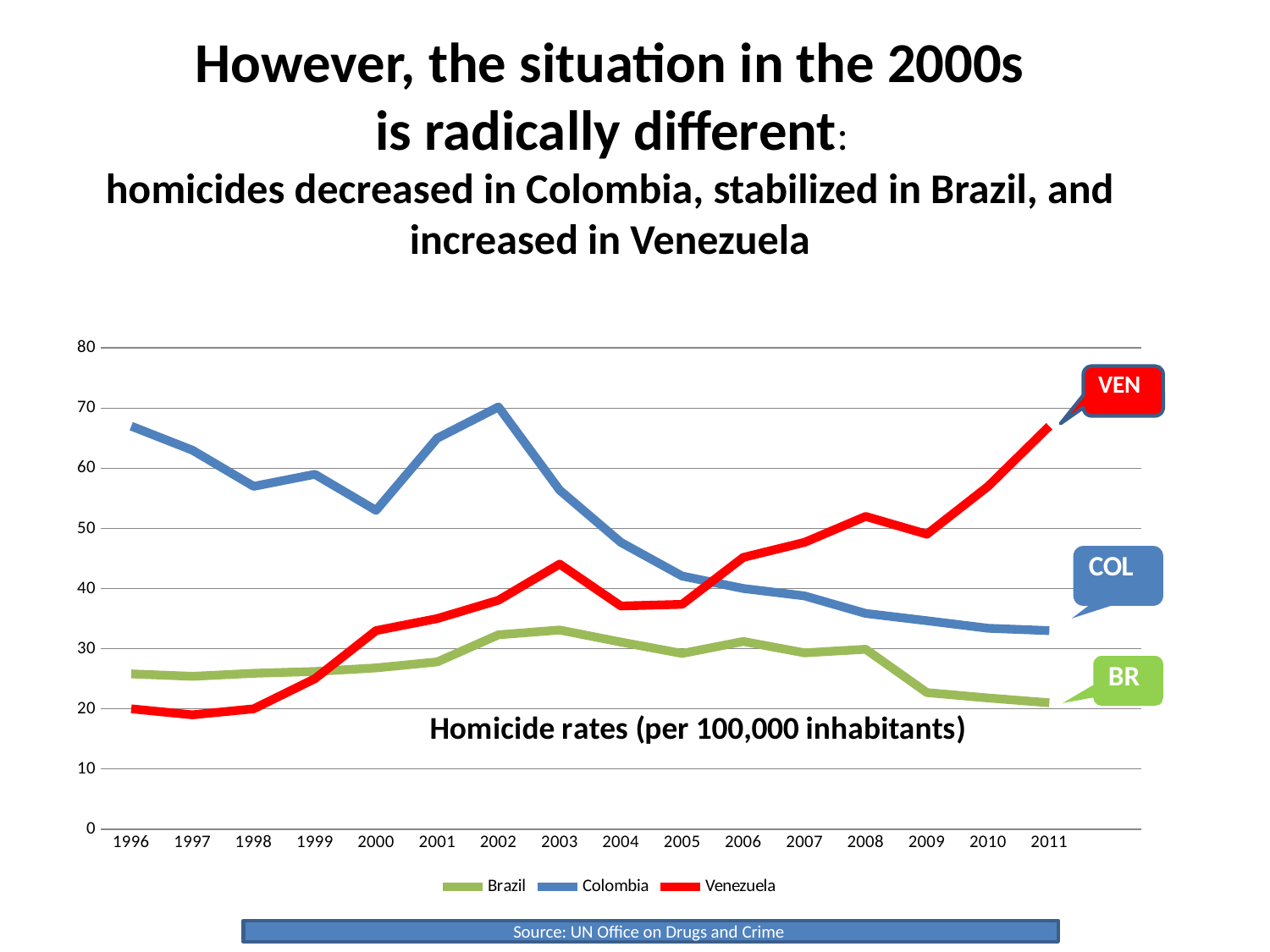
Is the value for Brazil in 2009 greater or less than 30? less Which is larger in 2011, the value for Venezuela or the value for Colombia? Venezuela What kind of chart is shown on the slide? line chart Is the value for Colombia in 1996 greater or less than 60? greater How many years are plotted along the x axis? 16 What is the title of the chart? Homicide rates (per 100,000 inhabitants) Which country had the highest homicide rate in 2011? Venezuela How many series does the legend list? 3 Does Colombia's homicide rate rise or fall from 2002 to 2011? fall In which year did Colombia's homicide rate peak? 2002 Which country had the lowest homicide rate in 2011? Brazil Which country had the highest homicide rate in 1996? Colombia